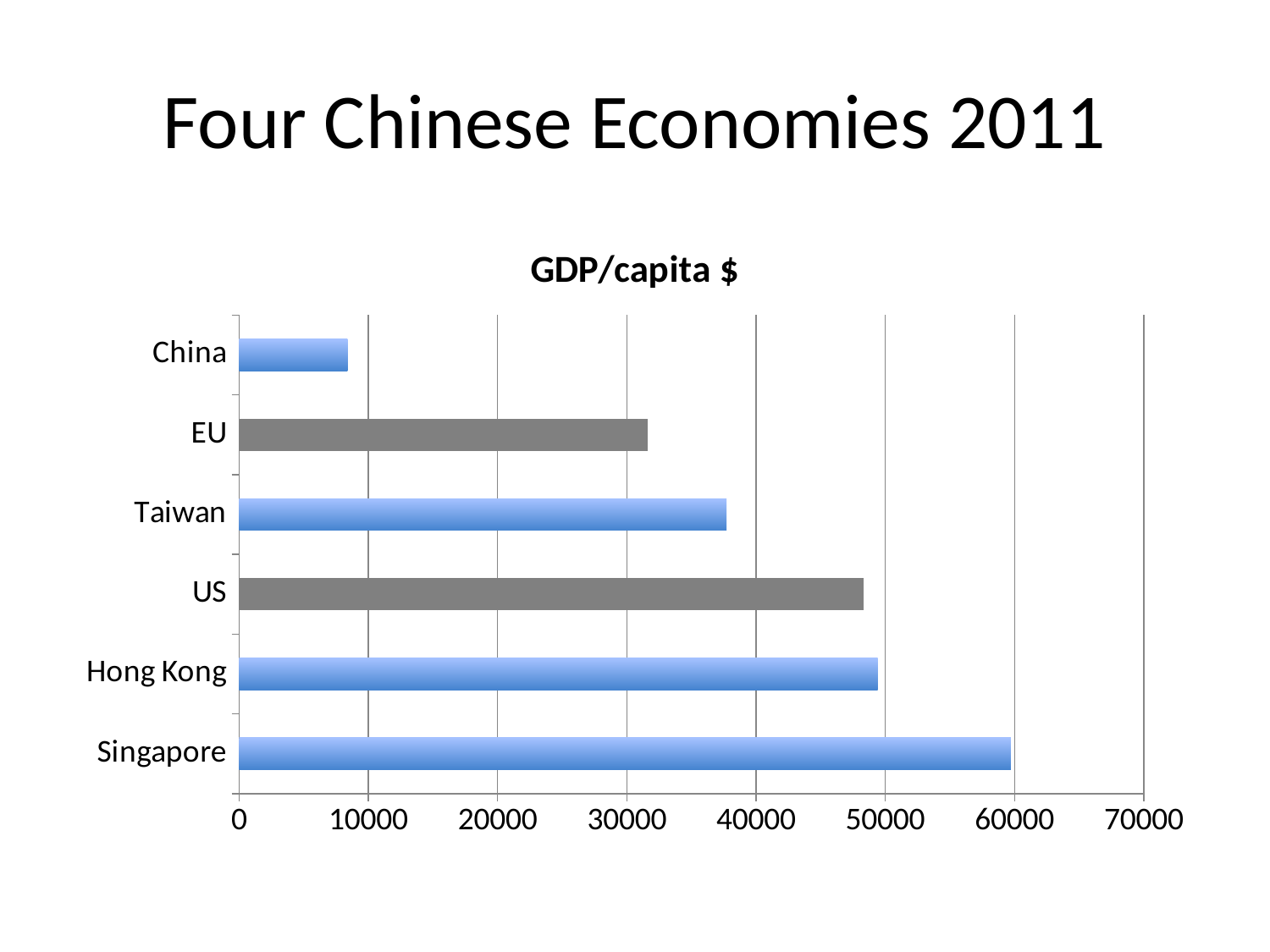
Which has a larger GDP/capita, Singapore or US? Singapore Which economy has the highest GDP/capita in the chart? Singapore Is the value for China greater or less than 10000? less What is the title of the chart? GDP/capita $ Which has a larger GDP/capita, Taiwan or EU? Taiwan Is the value for US greater or less than 40000? greater Is the value for Singapore greater or less than 50000? greater What kind of chart is shown on the slide? bar chart Which economy has the lowest GDP/capita in the chart? China How many economies are plotted in the chart? 6